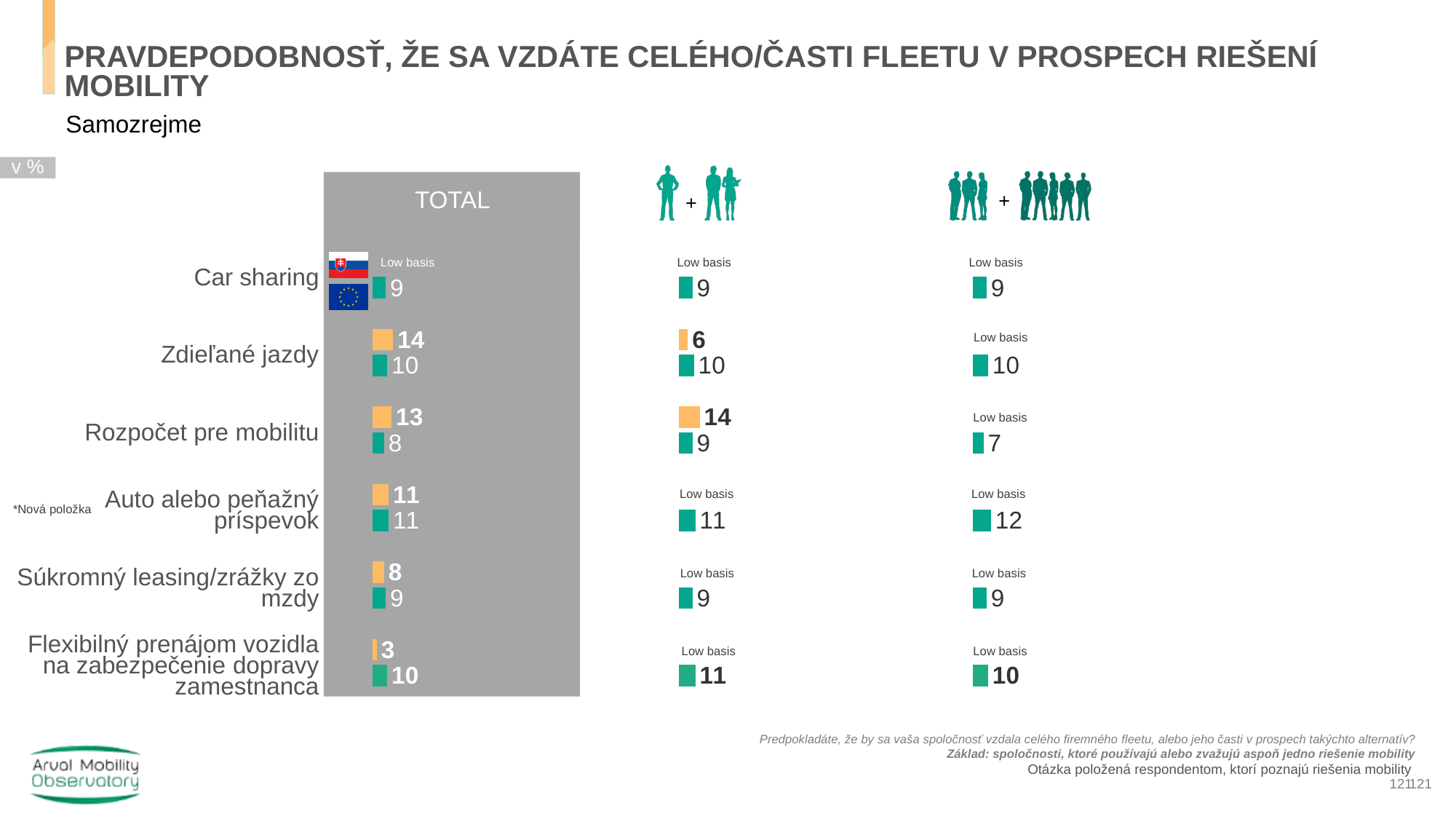
What type of chart is used on the slide? Bar chart In the TOTAL chart, what is the EU (green) value for Rozpočet pre mobilitu? 8 In the TOTAL chart, what is the Slovakia (orange) value for Flexibilný prenájom vozidla na zabezpečenie dopravy zamestnanca? 3 In the TOTAL chart, what is the Slovakia (orange) value for Zdieľané jazdy? 14 In the TOTAL chart, which category has the highest Slovakia (orange) value? Zdieľané jazdy In the TOTAL chart, what is the difference between the Slovakia and EU values for Rozpočet pre mobilitu? 5 In the right chart (large companies), what is the EU (green) value for Auto alebo peňažný príspevok? 12 In the middle chart (small companies), what is the Slovakia (orange) value for Rozpočet pre mobilitu? 14 In the middle chart (small companies), what is the Slovakia (orange) value for Zdieľané jazdy? 6 In the TOTAL chart, which is larger for Súkromný leasing/zrážky zo mzdy: the Slovakia value or the EU value? EU value In the TOTAL chart, which category has the lowest Slovakia (orange) value? Flexibilný prenájom vozidla na zabezpečenie dopravy zamestnanca How many categories are listed on the slide? 6